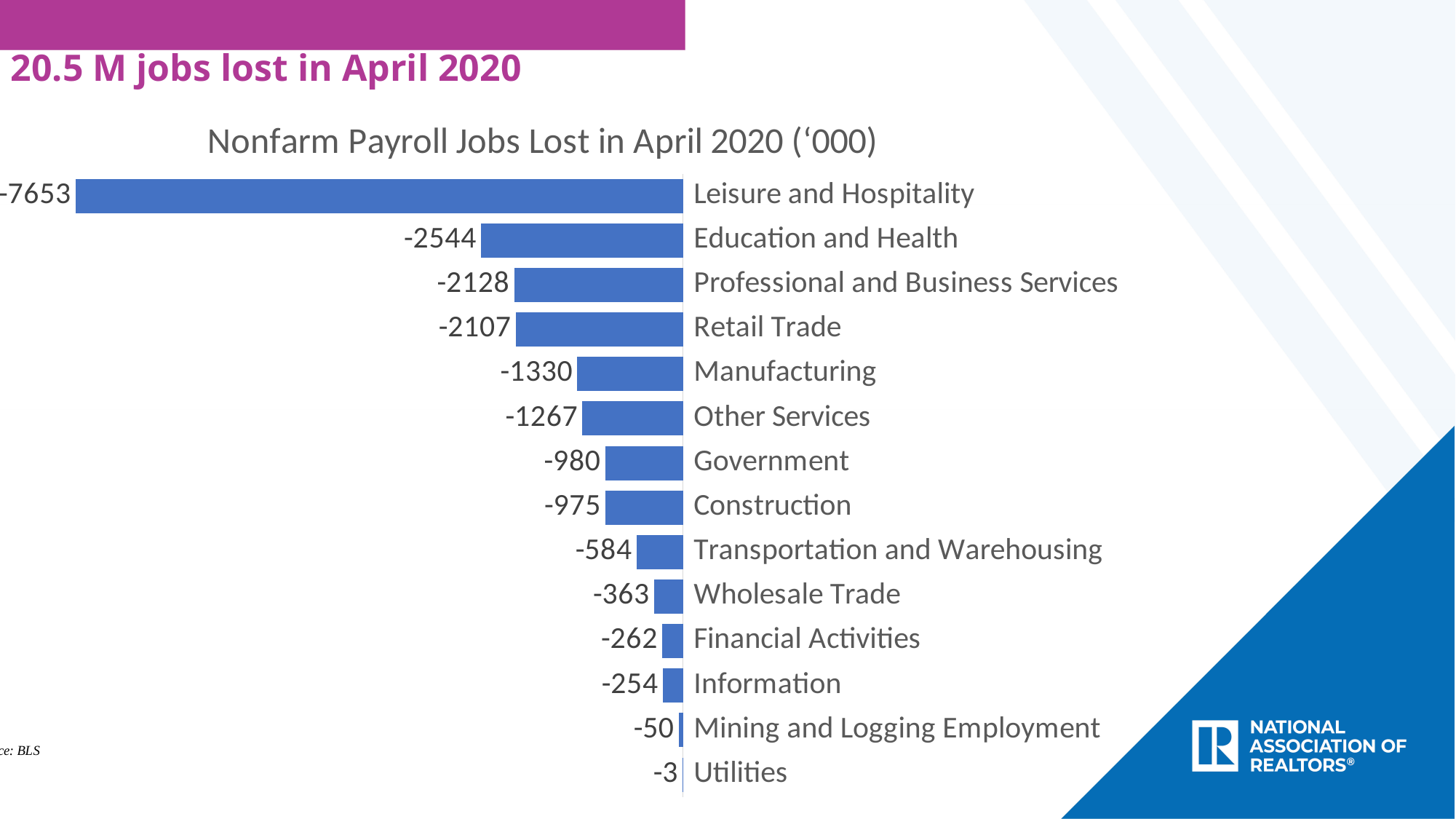
What is the title of the chart? Nonfarm Payroll Jobs Lost in April 2020 ('000) How many more thousand jobs were lost in Education and Health than in Professional and Business Services? 416 What is the difference between the job losses for Retail Trade and Manufacturing? 777 Which category lost more jobs, Manufacturing or Other Services? Manufacturing What is the value shown for Utilities? -3 Which category shows the smallest job loss? Utilities What kind of chart is shown on the slide? Bar chart What is the value shown for Retail Trade? -2107 What is the value shown for Transportation and Warehousing? -584 Which category shows the largest job loss? Leisure and Hospitality What is the value shown for Leisure and Hospitality? -7653 How many categories are shown in the chart? 14